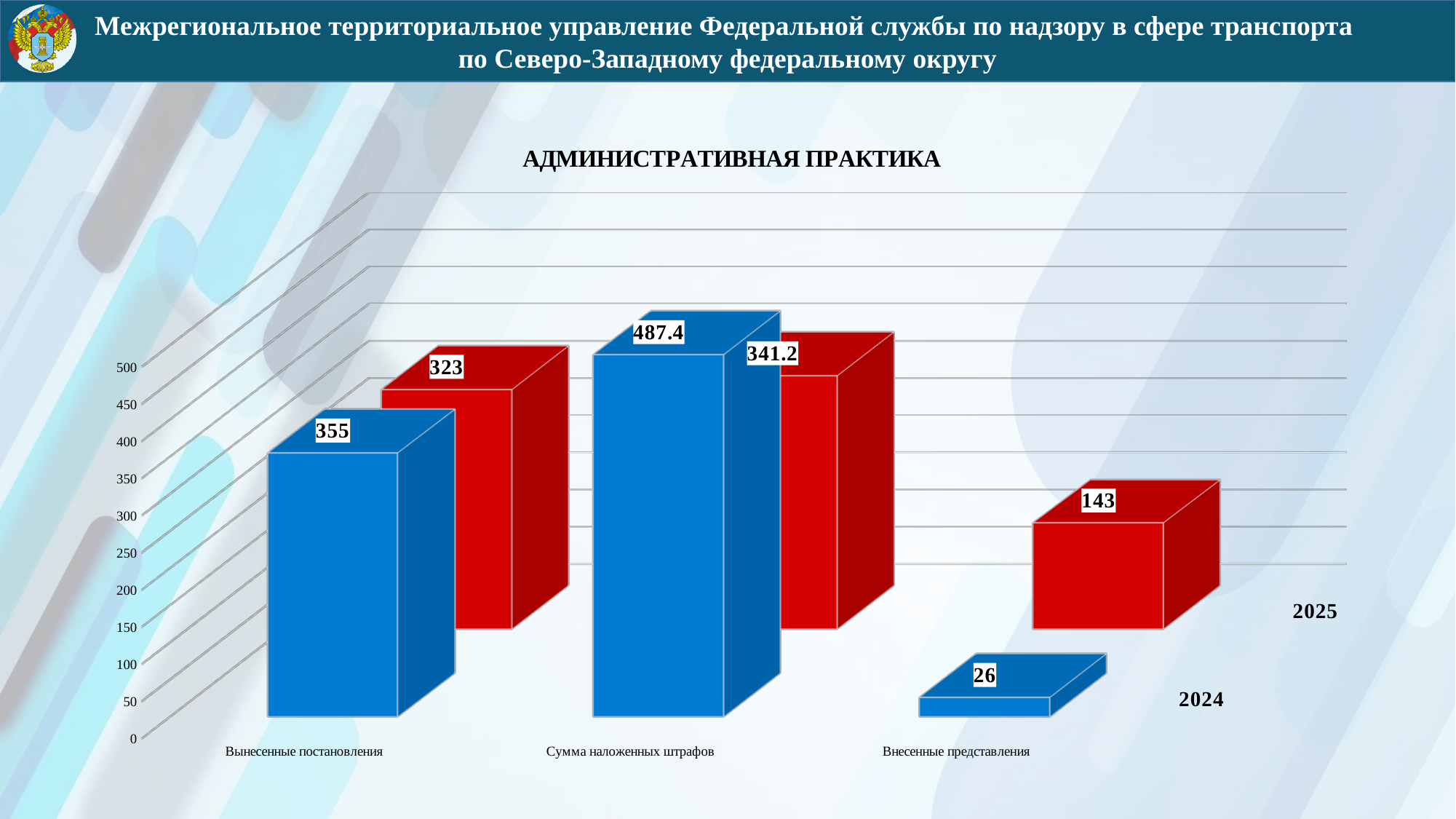
How many categories are shown on the x axis? 3 Which category has the lowest value in 2025? Внесенные представления How many series (years) does the chart show? 2 What is the value for Внесенные представления in 2025? 143 Which is larger for Сумма наложенных штрафов: the 2024 value or the 2025 value? 2024 What is the difference between the 2024 and 2025 values for Внесенные представления? 117 What is the value for Сумма наложенных штрафов in 2024? 487.4 What is the value for Сумма наложенных штрафов in 2025? 341.2 What is the value for Вынесенные постановления in 2024? 355 Which category has the highest value in 2024? Сумма наложенных штрафов What kind of chart is shown on the slide? Bar chart What is the value for Вынесенные постановления in 2025? 323